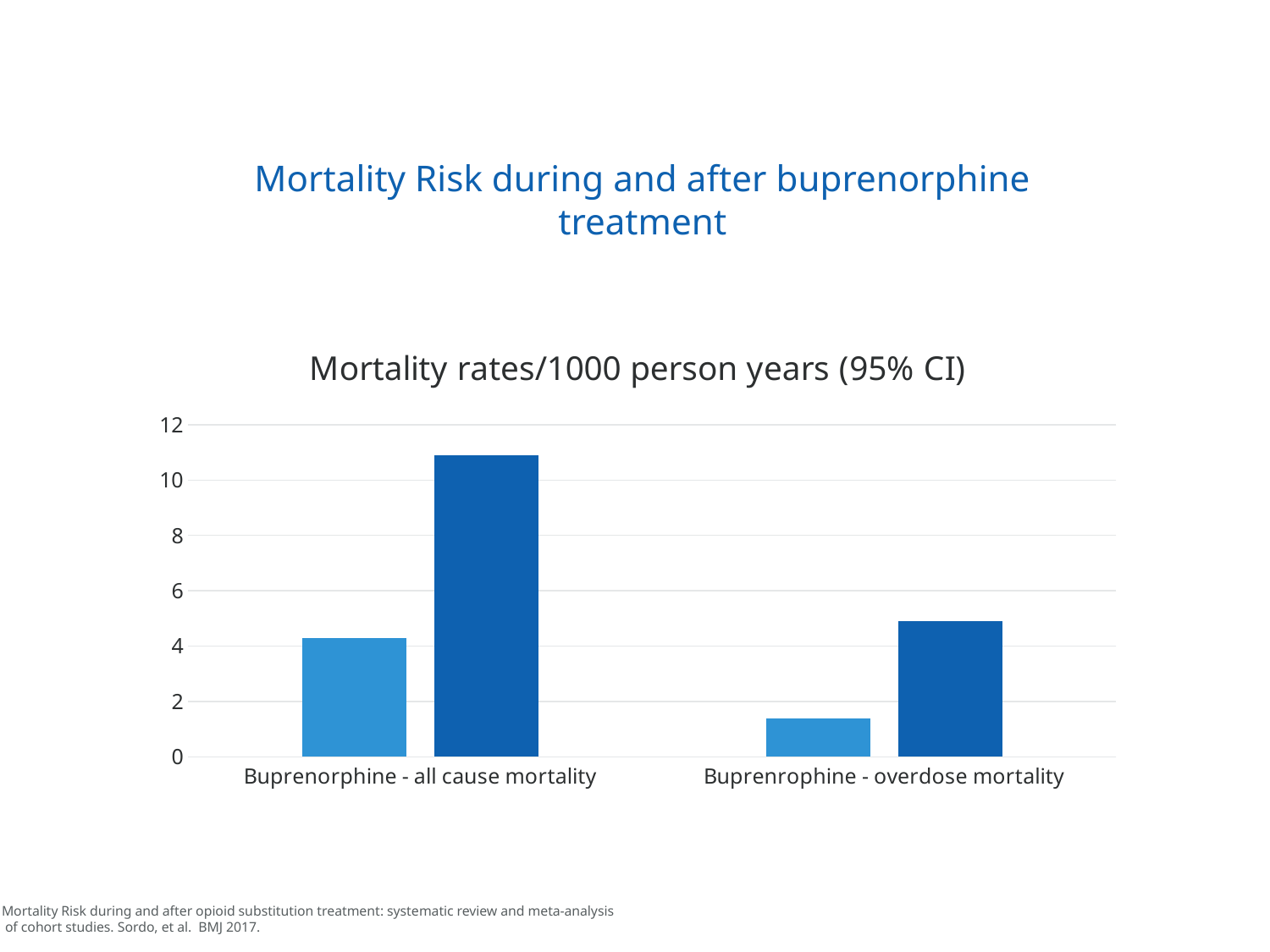
Is the value of the dark blue bar for 'Buprenrophine - overdose mortality' greater or less than 4? greater Which category has the shortest bar in the chart? Buprenrophine - overdose mortality Is the value of the dark blue bar for 'Buprenorphine - all cause mortality' greater or less than 10? greater Is the value of the light blue bar for 'Buprenorphine - all cause mortality' greater or less than 6? less What is the title of the chart? Mortality rates/1000 person years (95% CI) Which category has the tallest bar in the chart? Buprenorphine - all cause mortality How many categories are shown on the x axis of the chart? 2 How many bars are plotted in the chart? 4 Within 'Buprenorphine - all cause mortality', which bar is larger, the light blue or the dark blue? dark blue What kind of chart is shown on the slide? bar chart What is the highest value shown on the y axis of the chart? 12